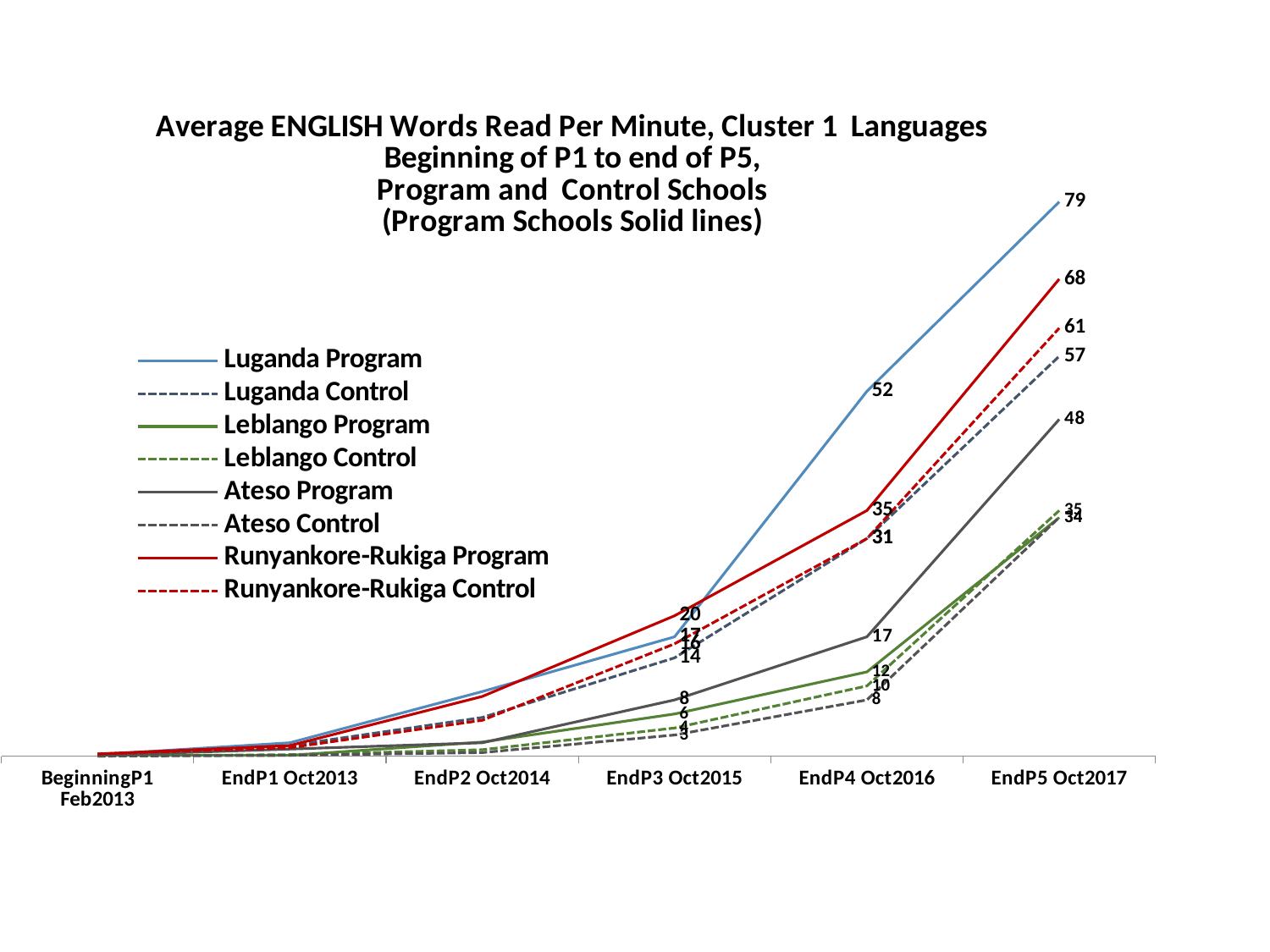
What is the value for Luganda Program at EndP4 Oct2016? 52 What is the value for Luganda Program at EndP5 Oct2017? 79 What is the value for Luganda Control at EndP5 Oct2017? 57 How many series does the legend list? 8 According to the title, what do the solid lines represent? Program Schools What is the value for Runyankore-Rukiga Program at EndP5 Oct2017? 68 Which series has the highest value at EndP5 Oct2017? Luganda Program What kind of chart is shown on the slide? line chart How many time points are shown along the x axis? 6 What is the value for Ateso Program at EndP5 Oct2017? 48 What is the difference between Luganda Program and Runyankore-Rukiga Program at EndP5 Oct2017? 11 At EndP5 Oct2017, which is larger: Runyankore-Rukiga Control or Luganda Control? Runyankore-Rukiga Control